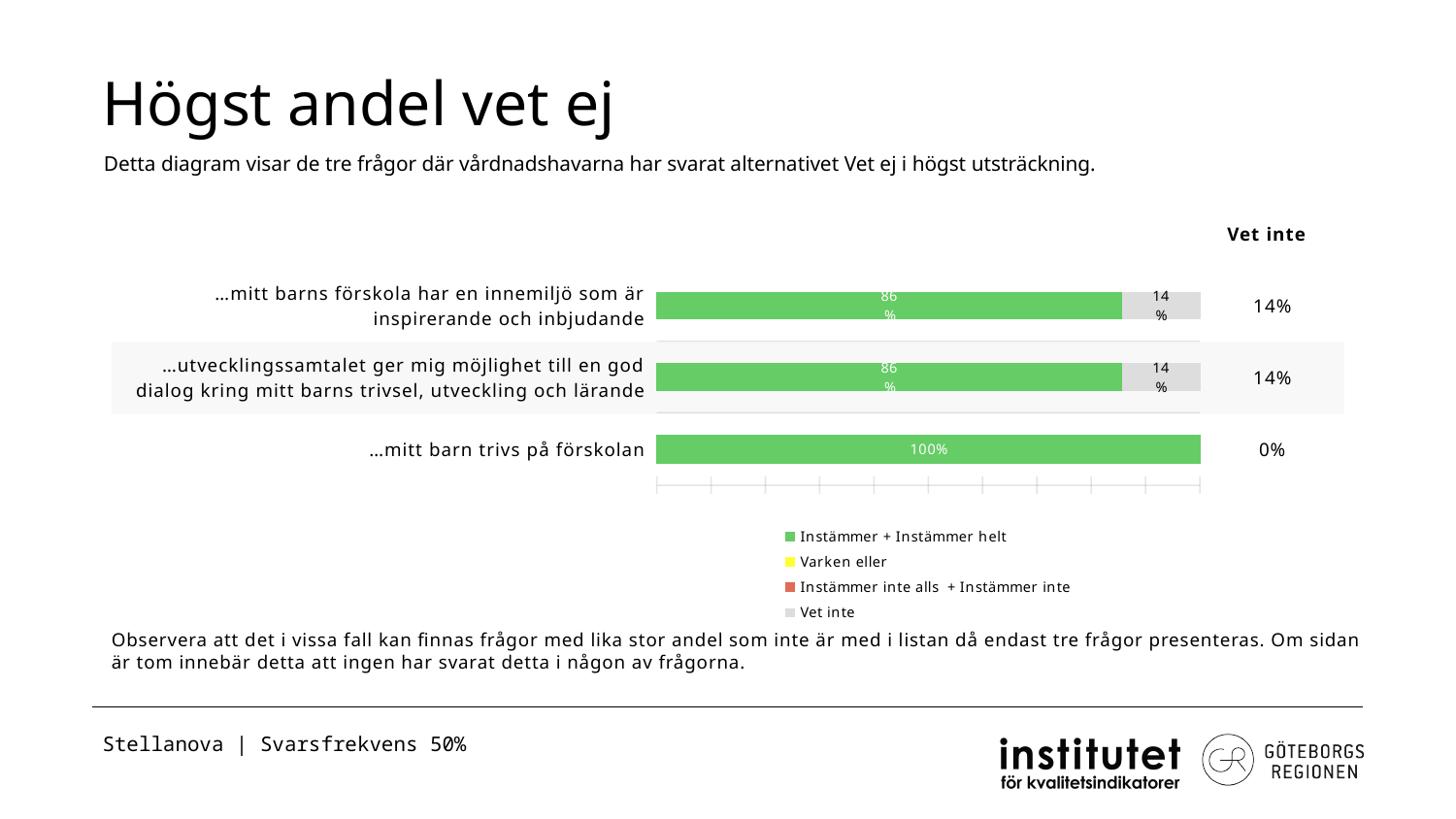
What kind of chart is shown on the slide? stacked bar chart Which question has the highest 'Instämmer + Instämmer helt' share? …mitt barn trivs på förskolan What is the 'Vet inte' value for '…mitt barns förskola har en innemiljö som är inspirerande och inbjudande'? 14% Which question has the lowest 'Vet inte' share? …mitt barn trivs på förskolan How many series does the legend list? 4 Which is larger for '…utvecklingssamtalet ger mig möjlighet till en god dialog kring mitt barns trivsel, utveckling och lärande': the 'Instämmer + Instämmer helt' share or the 'Vet inte' share? Instämmer + Instämmer helt What is the 'Instämmer + Instämmer helt' value for '…utvecklingssamtalet ger mig möjlighet till en god dialog kring mitt barns trivsel, utveckling och lärande'? 86% What is the difference between the 'Instämmer + Instämmer helt' value for '…mitt barn trivs på förskolan' and for '…mitt barns förskola har en innemiljö som är inspirerande och inbjudande'? 14% How many questions (categories) are plotted in the chart? 3 What is the 'Vet inte' value for '…mitt barn trivs på förskolan'? 0% What is the 'Instämmer + Instämmer helt' value for '…mitt barn trivs på förskolan'? 100% What is the title of the slide containing the chart? Högst andel vet ej